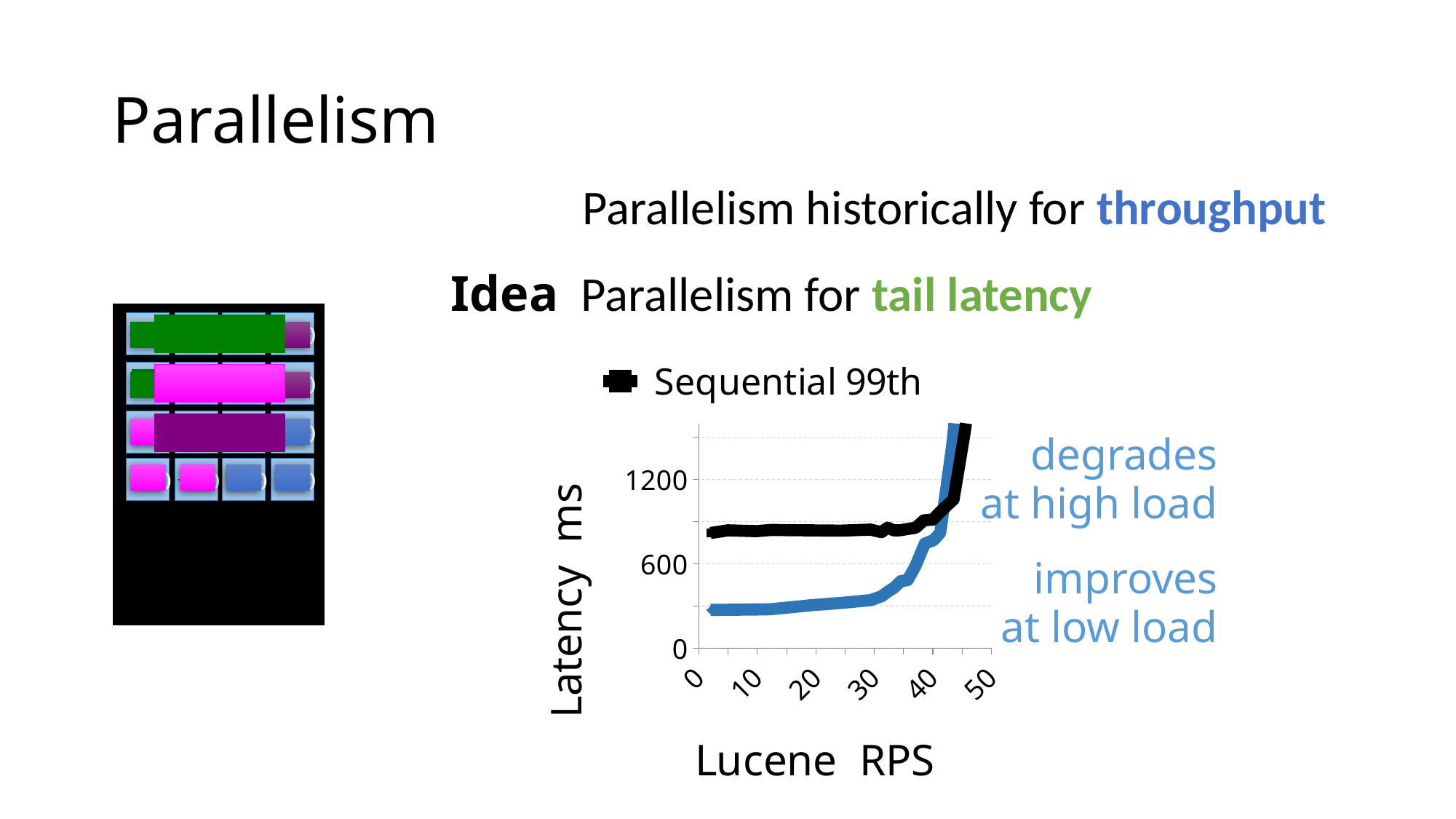
What is the label of the chart's y axis? Latency ms What is the highest tick value shown on the chart's x axis? 50 Is the Sequential 99th latency at 10 Lucene RPS greater or less than 600? greater Is the Sequential 99th latency at 20 Lucene RPS greater or less than 1200? less Does the blue line's latency rise or fall as Lucene RPS increases from 30 to 45? rise What kind of chart is shown on the slide? line chart Is the blue line's latency at 20 Lucene RPS greater or less than 0? greater How many series does the chart's legend list? 1 Does the Sequential 99th latency rise or fall as Lucene RPS increases from 40 to 47? rise What series name appears in the chart's legend? Sequential 99th At 20 Lucene RPS, which line shows higher latency, the black Sequential 99th line or the blue line? the black Sequential 99th line